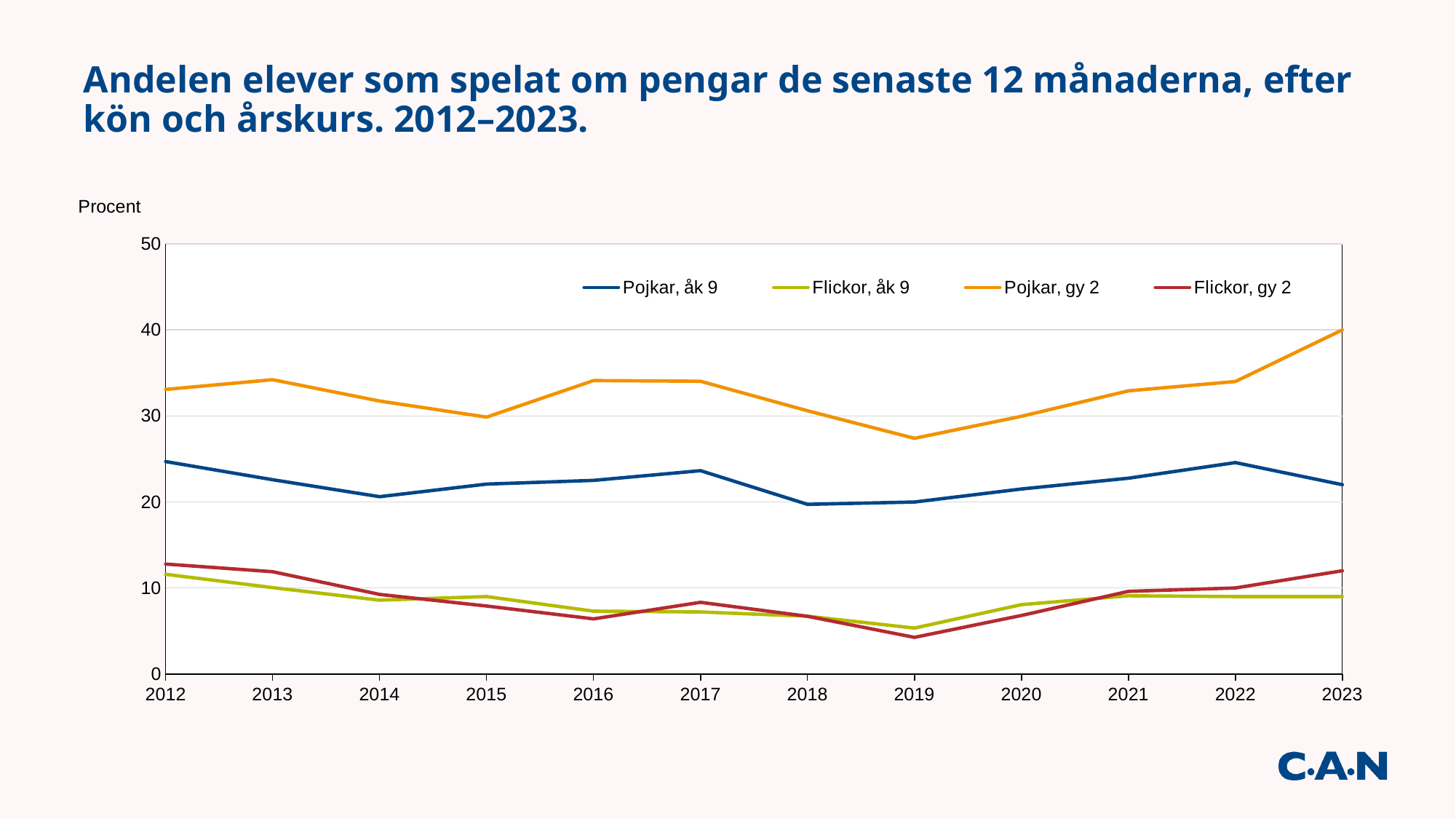
In which year is the value for Pojkar, gy 2 lowest? 2019 In 2023, which is larger: Flickor, gy 2 or Flickor, åk 9? Flickor, gy 2 Is the value for Flickor, gy 2 in 2019 greater or less than 10? less Is the value for Pojkar, åk 9 in 2012 greater or less than 20? greater How many years are plotted along the x axis? 12 How many series does the legend list? 4 What kind of chart is shown on the slide? line chart In which year is the value for Pojkar, gy 2 highest? 2023 What is the label on the vertical axis of the chart? Procent In which year is the value for Flickor, gy 2 lowest? 2019 Is the value for Pojkar, gy 2 in 2023 greater or less than 30? greater Does the value for Pojkar, gy 2 rise or fall from 2019 to 2023? rise